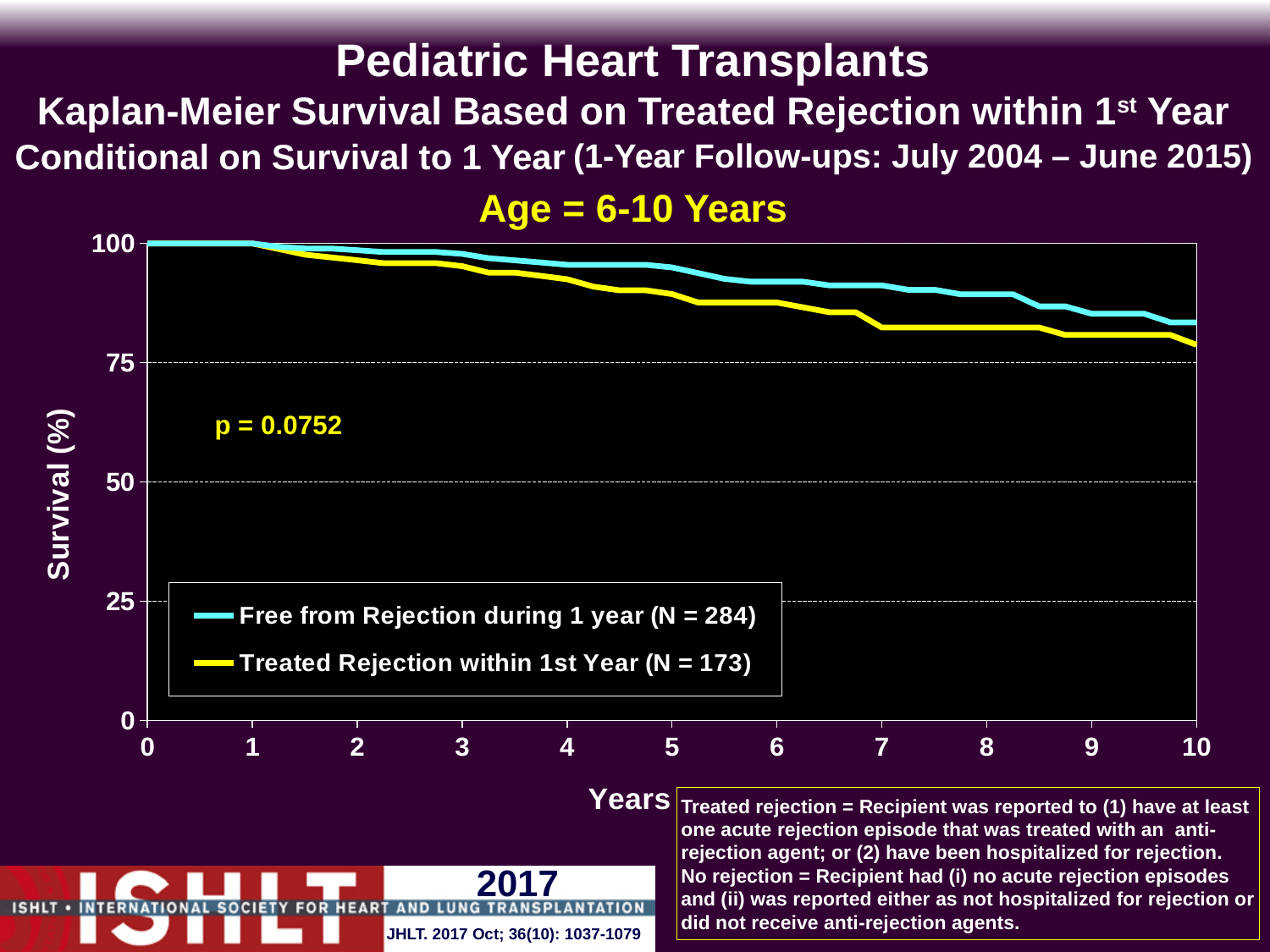
At year 10, which series has the higher survival: Free from Rejection during 1 year or Treated Rejection within 1st Year? Free from Rejection during 1 year Is the survival value for Treated Rejection within 1st Year at year 10 greater or less than 75? greater What p-value is printed on the chart? p = 0.0752 Is the survival value for Free from Rejection during 1 year at year 5 greater or less than 75? greater What colour is the line for Treated Rejection within 1st Year? Yellow What is the survival value for both series at year 0? 100 Do the survival curves rise or fall as years increase along the x axis? Fall How many series does the legend list? 2 Is the survival value for Treated Rejection within 1st Year at year 7 greater or less than 50? greater What kind of chart is shown on the slide? Line chart What is the N for the Treated Rejection within 1st Year series shown in the legend? 173 What is the N for the Free from Rejection during 1 year series shown in the legend? 284